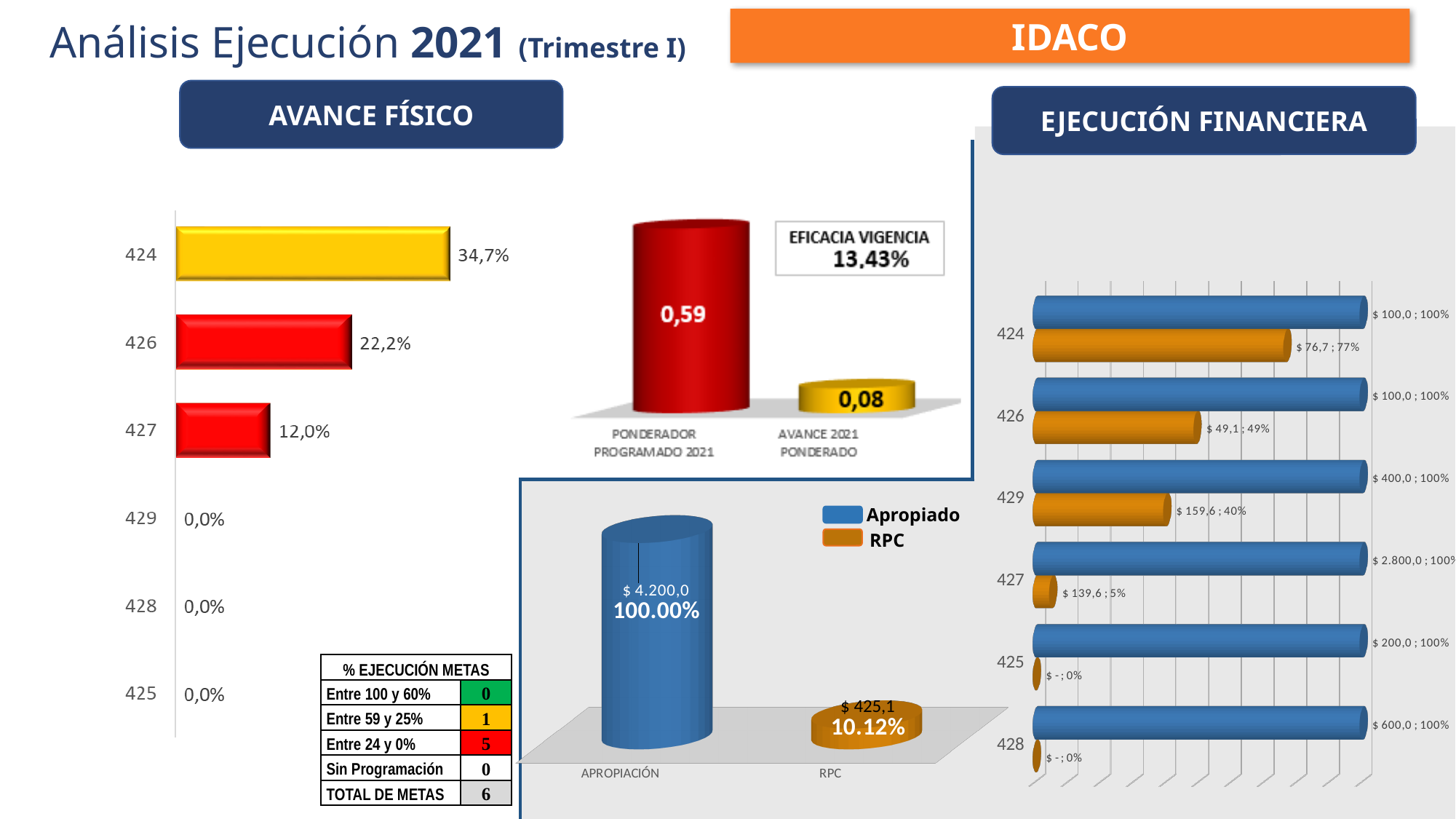
In the chart in the bottom middle of the slide, what is the value shown for RPC? $ 425,1 In the AVANCE FÍSICO bar chart on the left, how many categories are shown? 6 In the AVANCE FÍSICO bar chart on the left, what is the difference between the values for 426 and 427? 10,2% In the AVANCE FÍSICO bar chart on the left, what is the value for category 424? 34,7% In the AVANCE FÍSICO bar chart on the left, which category has the highest value? 424 In the AVANCE FÍSICO bar chart on the left, how many categories have a value of 0,0%? 3 In the EJECUCIÓN FINANCIERA chart on the right, how many series does the legend list? 2 What kind of chart is the EJECUCIÓN FINANCIERA chart on the right? Bar chart In the chart in the top middle of the slide, which is larger: PONDERADOR PROGRAMADO 2021 or AVANCE 2021 PONDERADO? PONDERADOR PROGRAMADO 2021 In the EJECUCIÓN FINANCIERA chart on the right, what is the RPC value for category 429? $ 159,6 ; 40% In the chart in the bottom middle of the slide, what percentage is shown for APROPIACIÓN? 100.00% In the chart in the top middle of the slide, what is the value for PONDERADOR PROGRAMADO 2021? 0,59